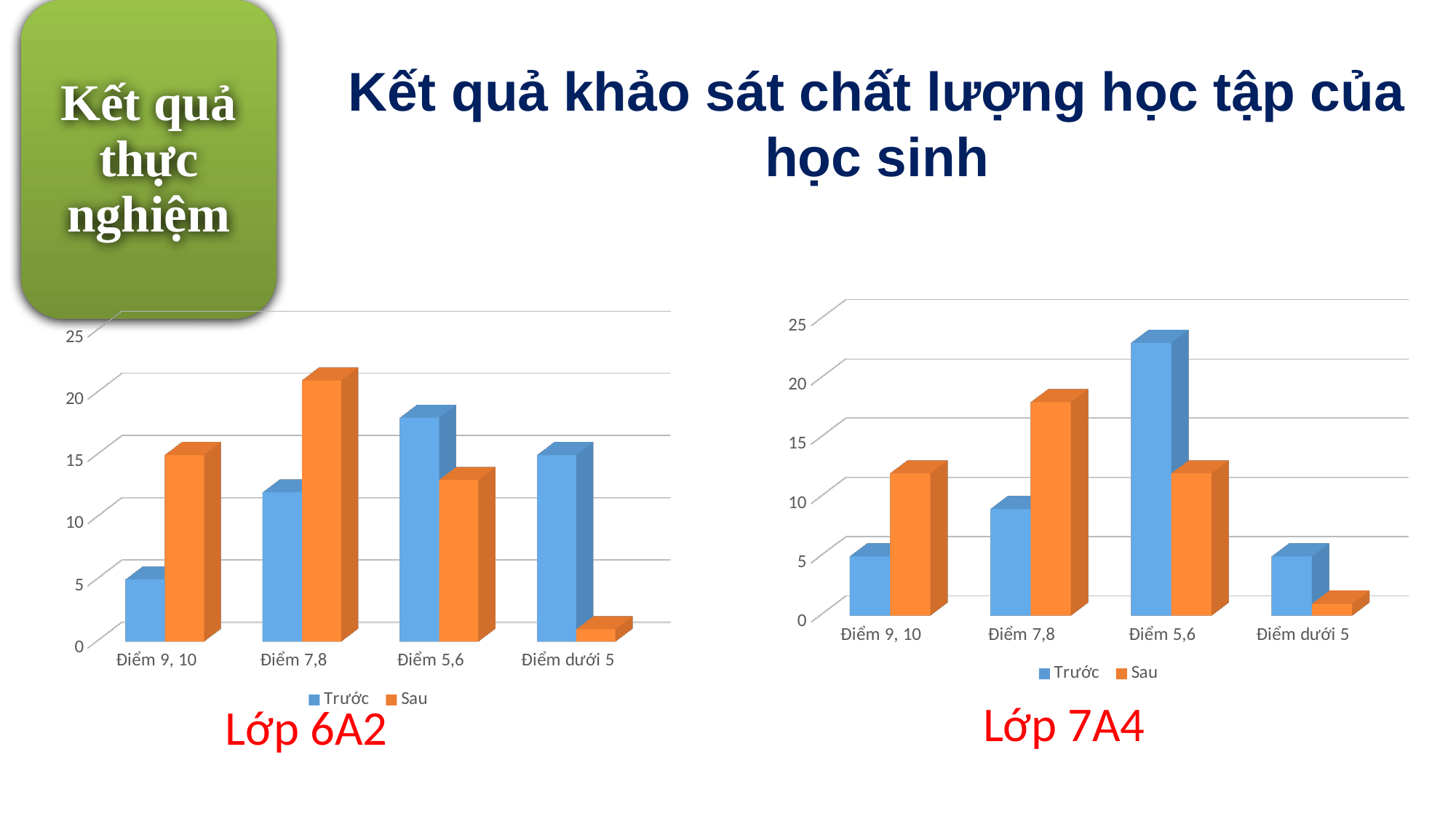
In the chart labelled Lớp 6A2, for Điểm dưới 5, which series has the larger value, Trước or Sau? Trước What kind of chart is the chart labelled Lớp 6A2? bar chart In the chart labelled Lớp 7A4, is the Trước value for Điểm 5,6 greater or less than 20? greater What are the two legend entries in the chart labelled Lớp 7A4? Trước, Sau In the chart labelled Lớp 6A2, how many series does the legend list? 2 In the chart labelled Lớp 6A2, which category has the highest Sau value? Điểm 7,8 In the chart labelled Lớp 7A4, how many categories are shown on the x axis? 4 In the chart labelled Lớp 6A2, which category has the lowest Sau value? Điểm dưới 5 In the chart labelled Lớp 6A2, is the Trước value for Điểm 9, 10 greater or less than 10? less In the chart labelled Lớp 7A4, for Điểm 7,8, which series has the larger value, Trước or Sau? Sau In the chart labelled Lớp 7A4, is the Sau value for Điểm dưới 5 greater or less than 5? less In the chart labelled Lớp 7A4, which category has the highest Trước value? Điểm 5,6